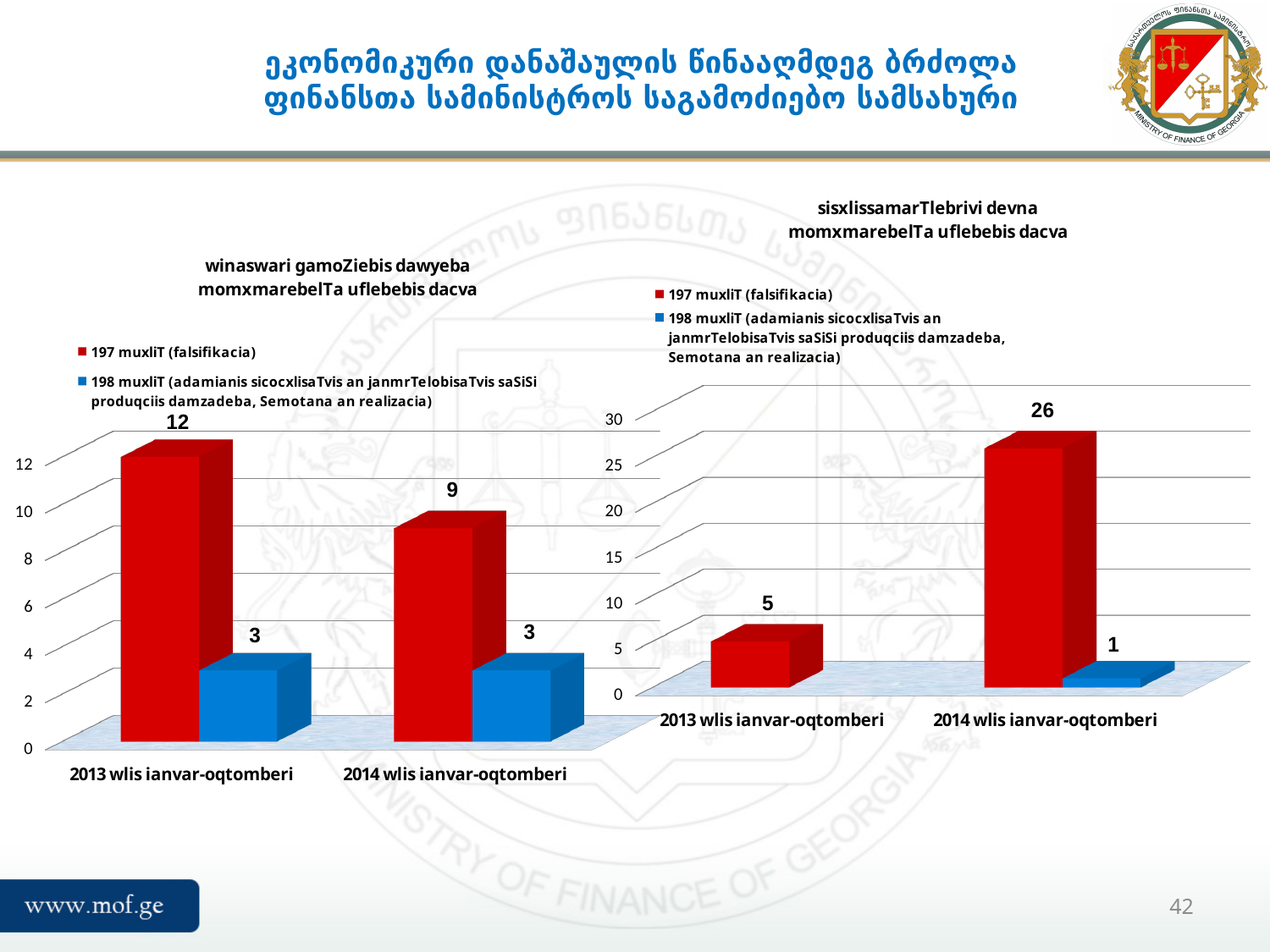
In the left chart (winaswari gamoZiebis dawyeba), what is the value for 198 muxliT in 2014 wlis ianvar-oqtomberi? 3 How many series does the legend of the right chart (sisxlissamarTlebrivi devna) list? 2 In the left chart (winaswari gamoZiebis dawyeba), does the value for 197 muxliT rise or fall from 2013 to 2014? fall In the right chart (sisxlissamarTlebrivi devna), what is the value for 197 muxliT (falsifikacia) in 2013 wlis ianvar-oqtomberi? 5 In the left chart (winaswari gamoZiebis dawyeba), what is the value for 197 muxliT (falsifikacia) in 2014 wlis ianvar-oqtomberi? 9 In the left chart (winaswari gamoZiebis dawyeba), what is the difference between the 197 muxliT values for 2013 and 2014? 3 In the right chart (sisxlissamarTlebrivi devna), what is the difference between the 197 muxliT values for 2014 and 2013? 21 In the right chart (sisxlissamarTlebrivi devna), which year has the higher value for 197 muxliT (falsifikacia)? 2014 wlis ianvar-oqtomberi In the right chart (sisxlissamarTlebrivi devna), what is the value for 197 muxliT (falsifikacia) in 2014 wlis ianvar-oqtomberi? 26 In the left chart (winaswari gamoZiebis dawyeba), what is the value for 197 muxliT (falsifikacia) in 2013 wlis ianvar-oqtomberi? 12 In the right chart (sisxlissamarTlebrivi devna), what is the value for 198 muxliT in 2014 wlis ianvar-oqtomberi? 1 What type of chart is the left chart (winaswari gamoZiebis dawyeba)? bar chart